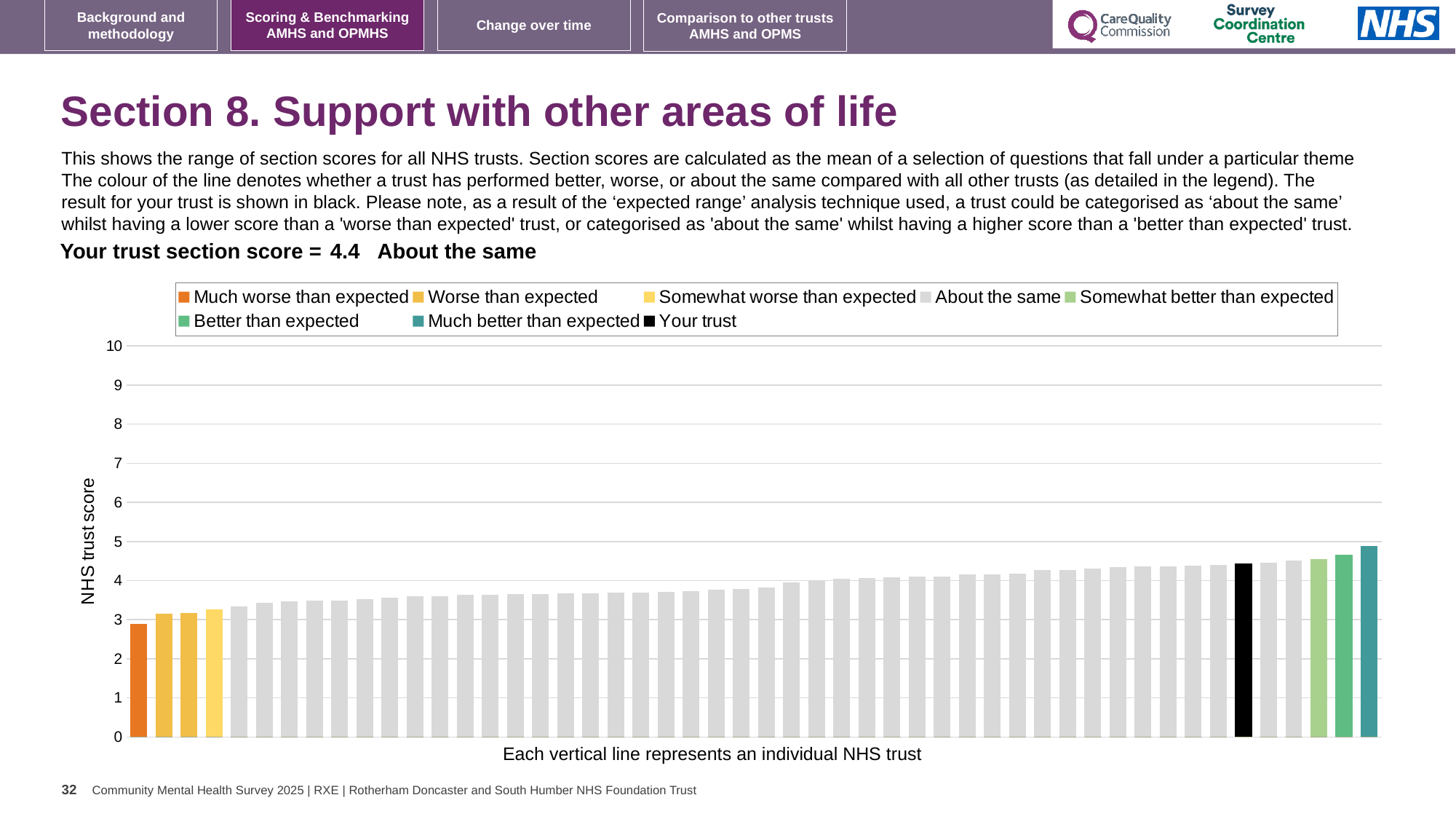
Is the value of the black bar (your trust) greater or less than 4? greater What kind of chart is shown on the slide? Bar chart Is the value of the highest bar greater or less than 4? greater Which legend category does the lowest bar in the chart belong to? Much worse than expected What is the label on the vertical axis of the chart? NHS trust score Which legend category does the highest bar in the chart belong to? Much better than expected What is the section score for your trust? 4.4 How many entries does the chart legend list? 8 Is the value of the lowest bar greater or less than 3? less Which performance category is your trust placed in for this section? About the same What is the maximum value shown on the vertical axis? 10 Do the bar values rise or fall from left to right along the x axis? Rise